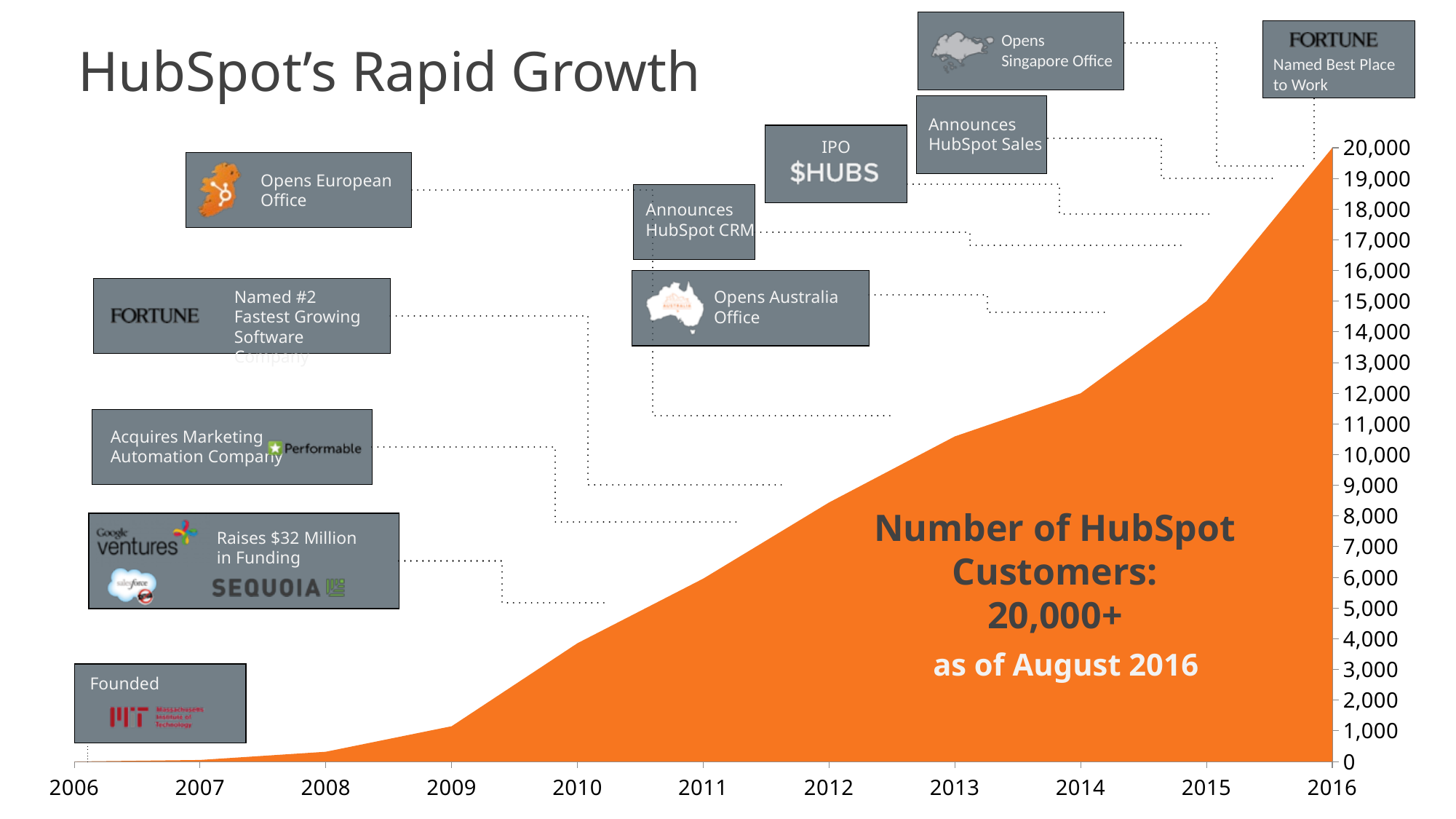
Which year has the lowest number of HubSpot customers? 2006 Is the value for 2013 greater or less than 10,000? greater What colour is the area in the chart? orange Do the values rise or fall from 2006 to 2016? rise What is the number of HubSpot customers in 2016 according to the chart? 20,000 Is the value for 2008 greater or less than 1,000? less Which year has the highest number of HubSpot customers? 2016 Is the value for 2010 greater or less than 3,000? greater What kind of chart is shown on the slide? area chart How many years are shown along the x axis of the chart? 11 Which year has more customers, 2012 or 2015? 2015 What is the title of the slide's chart? HubSpot's Rapid Growth